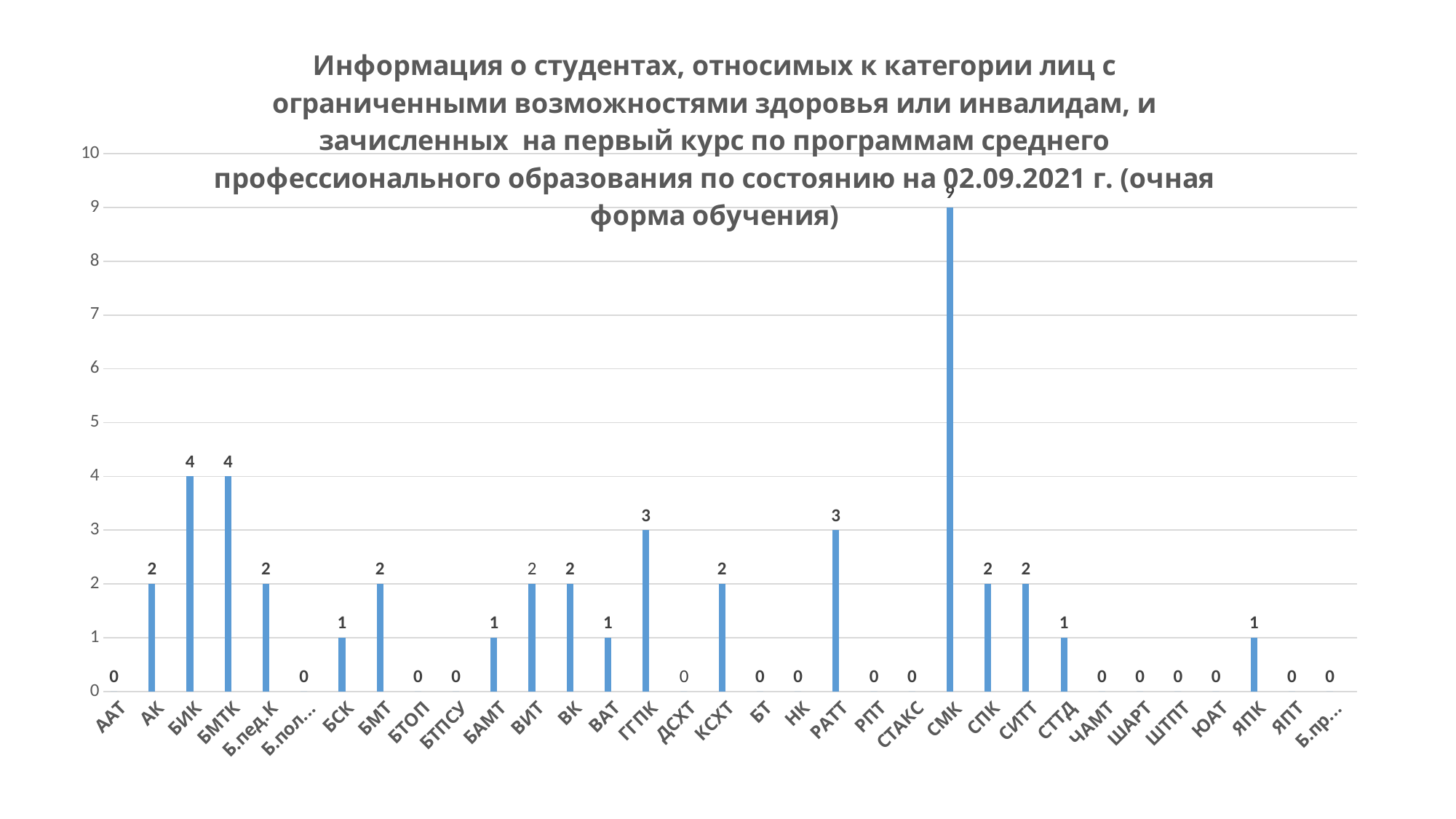
Which is larger, the value for БМТК or the value for ВИТ? БМТК What kind of chart is shown on the slide? bar chart What is the value for ААТ? 0 What is the value for СТТД? 1 What is the value for СМК? 9 How many categories are shown on the x axis? 33 What is the value for БИК? 4 What is the value for ГГПК? 3 What is the difference between the values for СМК and РАТТ? 6 Is the value for СМК greater or less than 5? greater Which category has the highest value? СМК What is the difference between the values for БМТК and БСК? 3